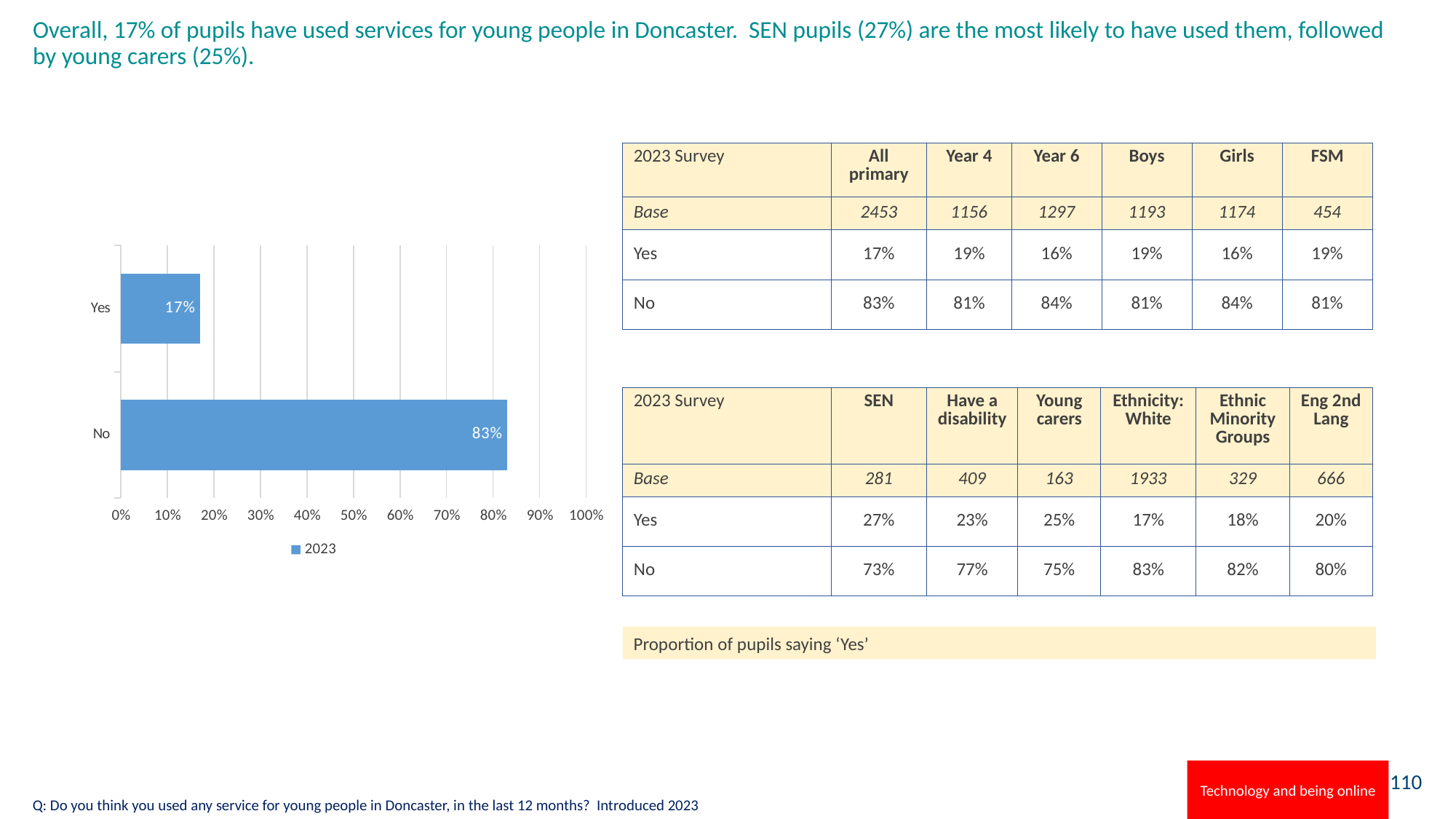
What kind of chart is shown on the slide? Bar chart What is the difference between the 'No' and 'Yes' values in the bar chart? 66% Which category has the lowest value in the bar chart? Yes How many series does the legend of the bar chart list? 1 Is the value for 'No' in the bar chart greater or less than 80%? greater What is the value for 'Yes' in the bar chart? 17% How many categories are shown in the bar chart? 2 Is the value for 'Yes' in the bar chart greater or less than 20%? less What is the value for 'No' in the bar chart? 83% Which is larger in the bar chart, the value for 'Yes' or the value for 'No'? No Which category has the highest value in the bar chart? No What series name is shown in the legend of the bar chart? 2023